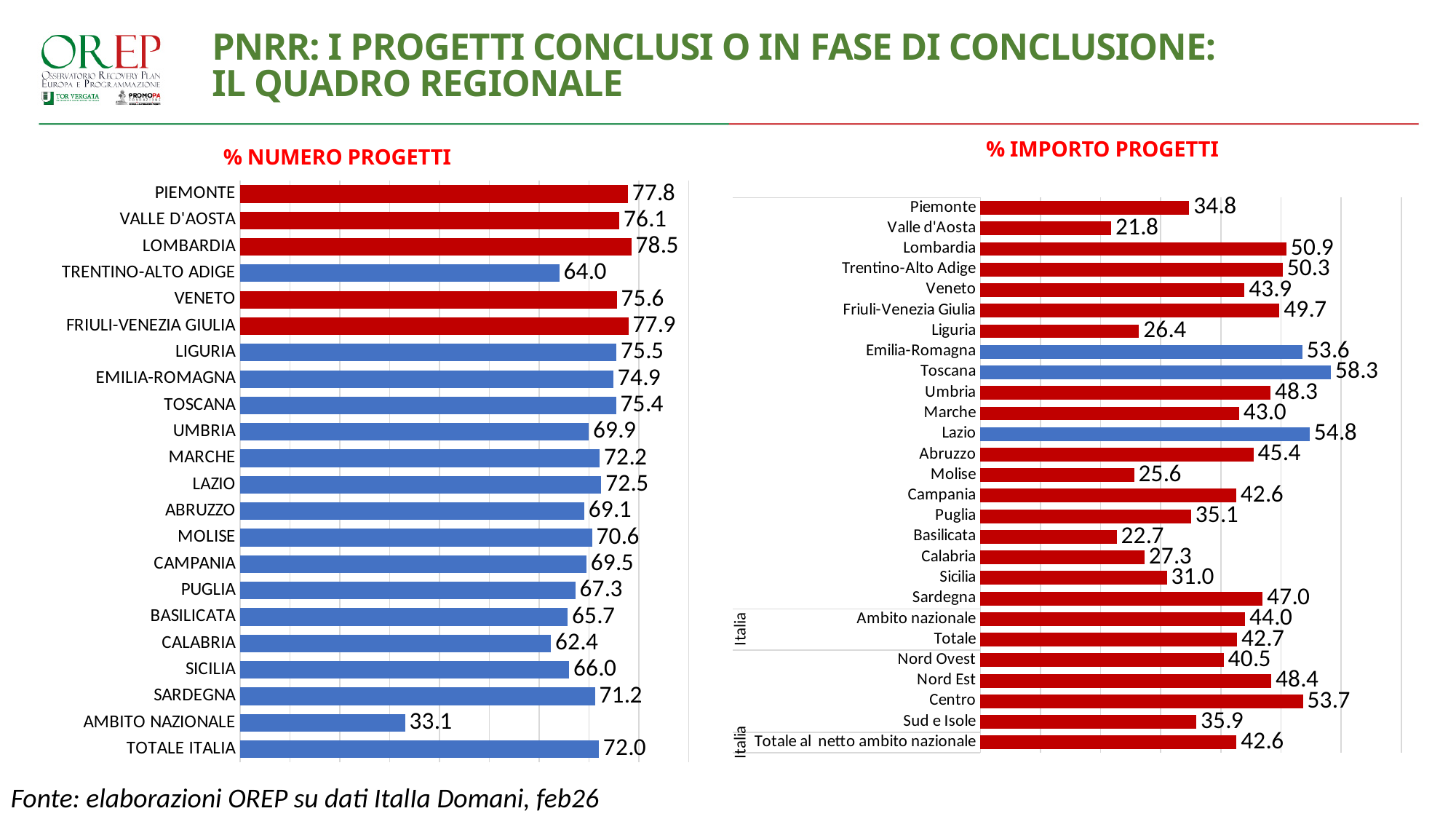
In the % IMPORTO PROGETTI chart, what is the difference between the values for Nord Est and Nord Ovest? 7.9 In the % NUMERO PROGETTI chart, what is the difference between the values for PIEMONTE and CALABRIA? 15.4 In the % IMPORTO PROGETTI chart, what is the value for Totale al netto ambito nazionale? 42.6 In the % NUMERO PROGETTI chart, which category has the highest value? LOMBARDIA In the % IMPORTO PROGETTI chart, which is larger, the value for Lazio or the value for Lombardia? Lazio In the % IMPORTO PROGETTI chart, which category has the highest value? Toscana What kind of chart is the % IMPORTO PROGETTI chart? Bar chart In the % NUMERO PROGETTI chart, what is the value for LOMBARDIA? 78.5 In the % IMPORTO PROGETTI chart, what is the value for Toscana? 58.3 In the % NUMERO PROGETTI chart, what is the value for TOTALE ITALIA? 72.0 In the % NUMERO PROGETTI chart, which category has the lowest value? AMBITO NAZIONALE In the % IMPORTO PROGETTI chart, which category has the lowest value? Valle d'Aosta